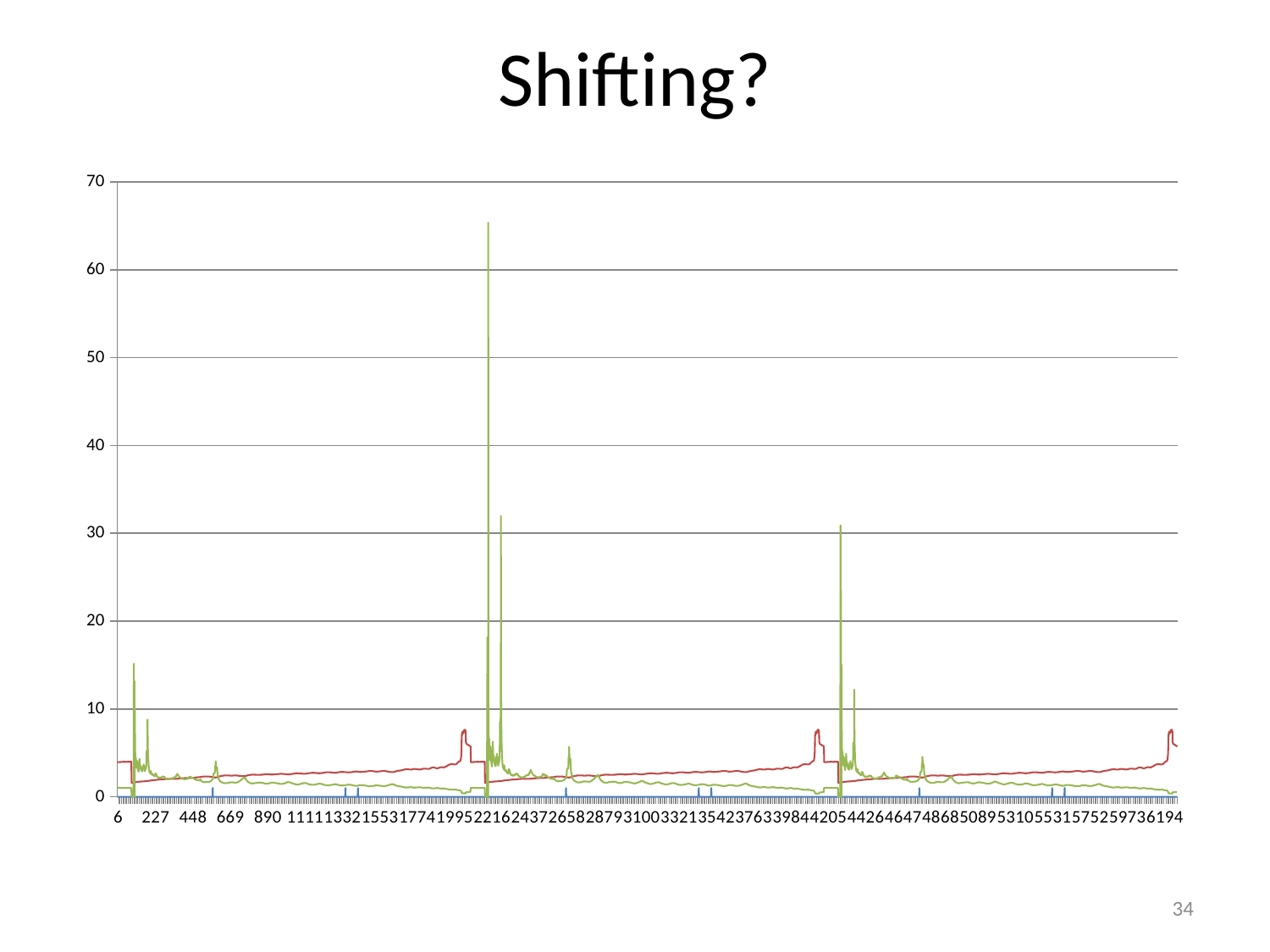
Is the highest point of the red line greater or less than 10? less What is the title of the slide containing the chart? Shifting? Is the second-tallest green spike (near the right-hand third of the chart) greater or less than 40? less What is the highest value shown on the vertical axis of the chart? 70 What is the first label shown on the horizontal axis? 6 What kind of chart is shown on the slide? line chart What is the lowest value shown on the vertical axis of the chart? 0 Is the tallest peak of the green line greater or less than 70? less Which coloured line reaches the highest value on the chart, the green line or the red line? green